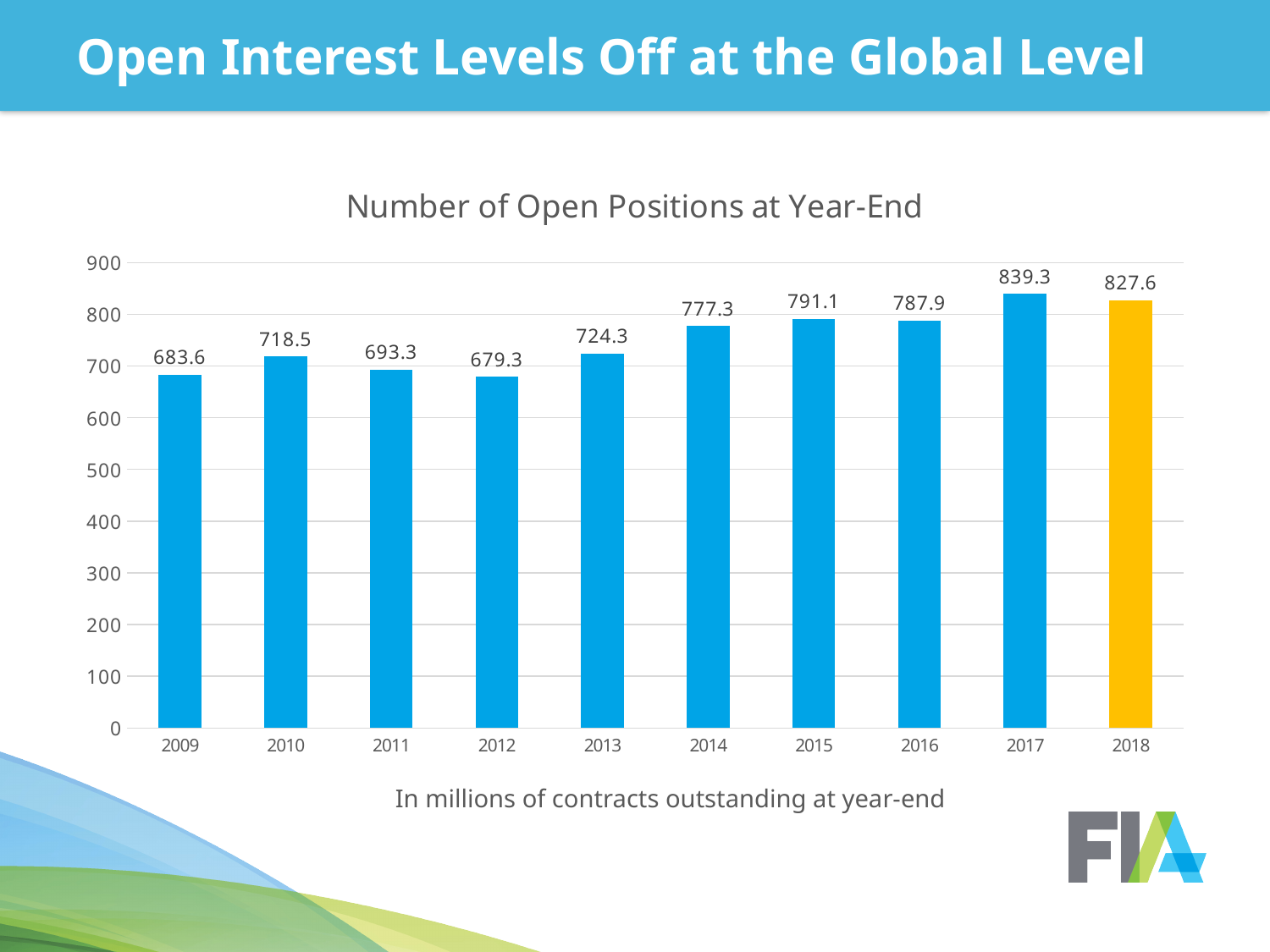
Is the value for 2013 greater or less than 700? greater What kind of chart is shown on the slide? Bar chart How many years are shown on the x axis? 10 What is the difference between the 2009 and 2010 values? 34.9 What is the title of the chart? Number of Open Positions at Year-End Which year has the highest number of open positions at year-end? 2017 Which year has a larger value, 2014 or 2016? 2016 Which year has the lowest number of open positions at year-end? 2012 What is the difference between the 2017 and 2018 values? 11.7 What is the number of open positions at year-end for 2018? 827.6 What is the number of open positions at year-end for 2015? 791.1 What is the number of open positions at year-end for 2012? 679.3